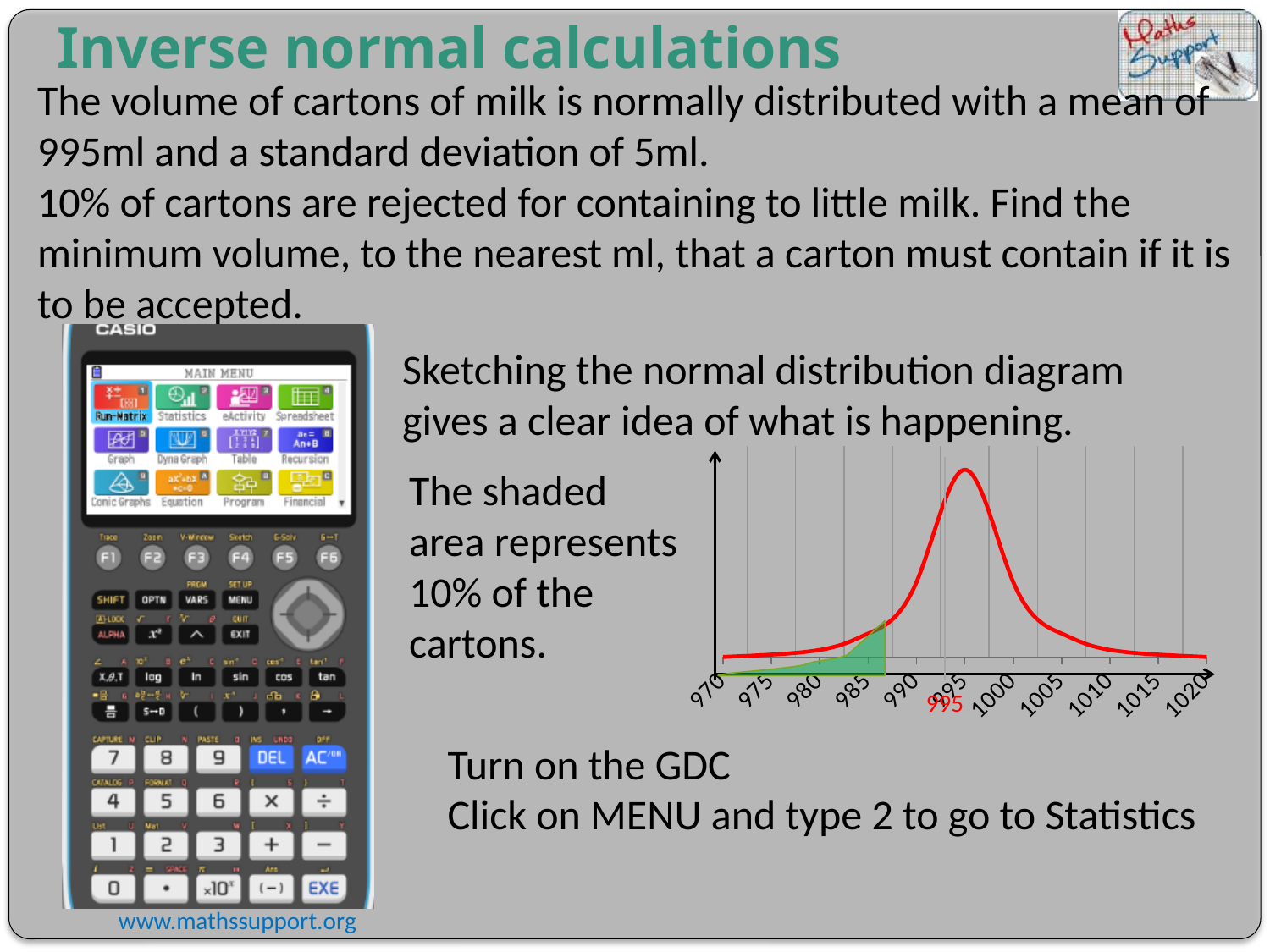
How many labelled tick values are shown on the x-axis of the normal distribution diagram? 11 Which x-axis value is written in red beneath the diagram? 995 What is the smallest value labelled on the x-axis of the normal distribution diagram? 970 According to the slide, what percentage of the cartons does the shaded area represent? 10% What kind of chart is the normal distribution diagram on the slide? Line chart At which x-axis value does the red curve reach its peak? 995 What is the largest value labelled on the x-axis of the normal distribution diagram? 1020 Does the red curve rise or fall as x increases from 995 to 1020? Falls Is the shaded green area under the curve to the left or to the right of 990 on the x-axis? Left Does the red curve rise or fall as x increases from 970 to 995? Rises